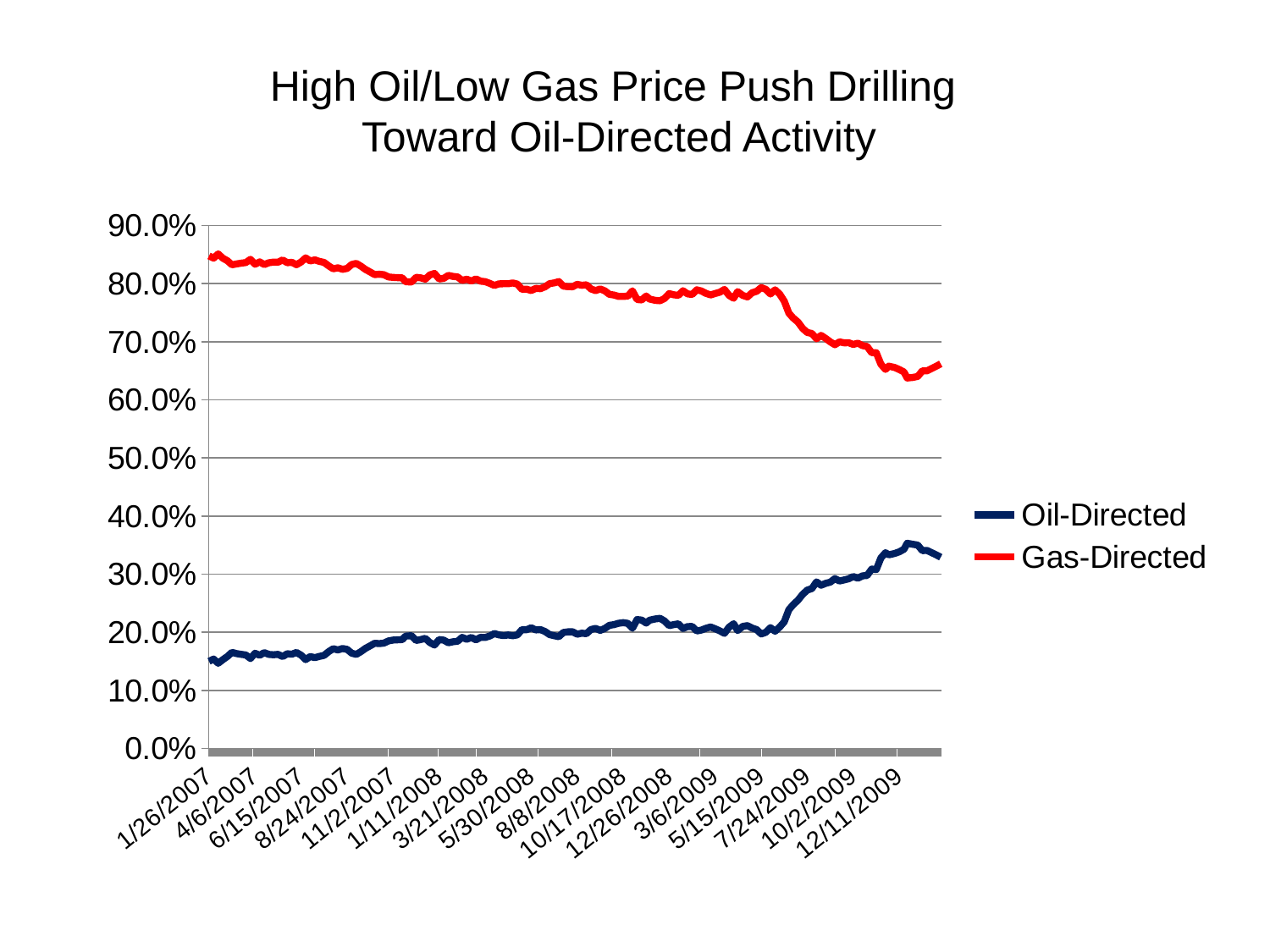
Which series has the higher value at 7/24/2009, Oil-Directed or Gas-Directed? Gas-Directed How many date labels are shown on the x axis? 16 Is the Oil-Directed value at 1/26/2007 greater or less than 20.0%? less Is the Gas-Directed value at 12/11/2009 greater or less than 70.0%? less Which colour is used for the Gas-Directed line? Red Is the Gas-Directed value at 1/26/2007 greater or less than 80.0%? greater How many series does the legend list? 2 What kind of chart is shown on the slide? Line chart Does the Gas-Directed line rise or fall from 1/26/2007 to 12/11/2009? Fall Does the Oil-Directed line rise or fall from 1/26/2007 to 12/11/2009? Rise What is the title of the chart? High Oil/Low Gas Price Push Drilling Toward Oil-Directed Activity